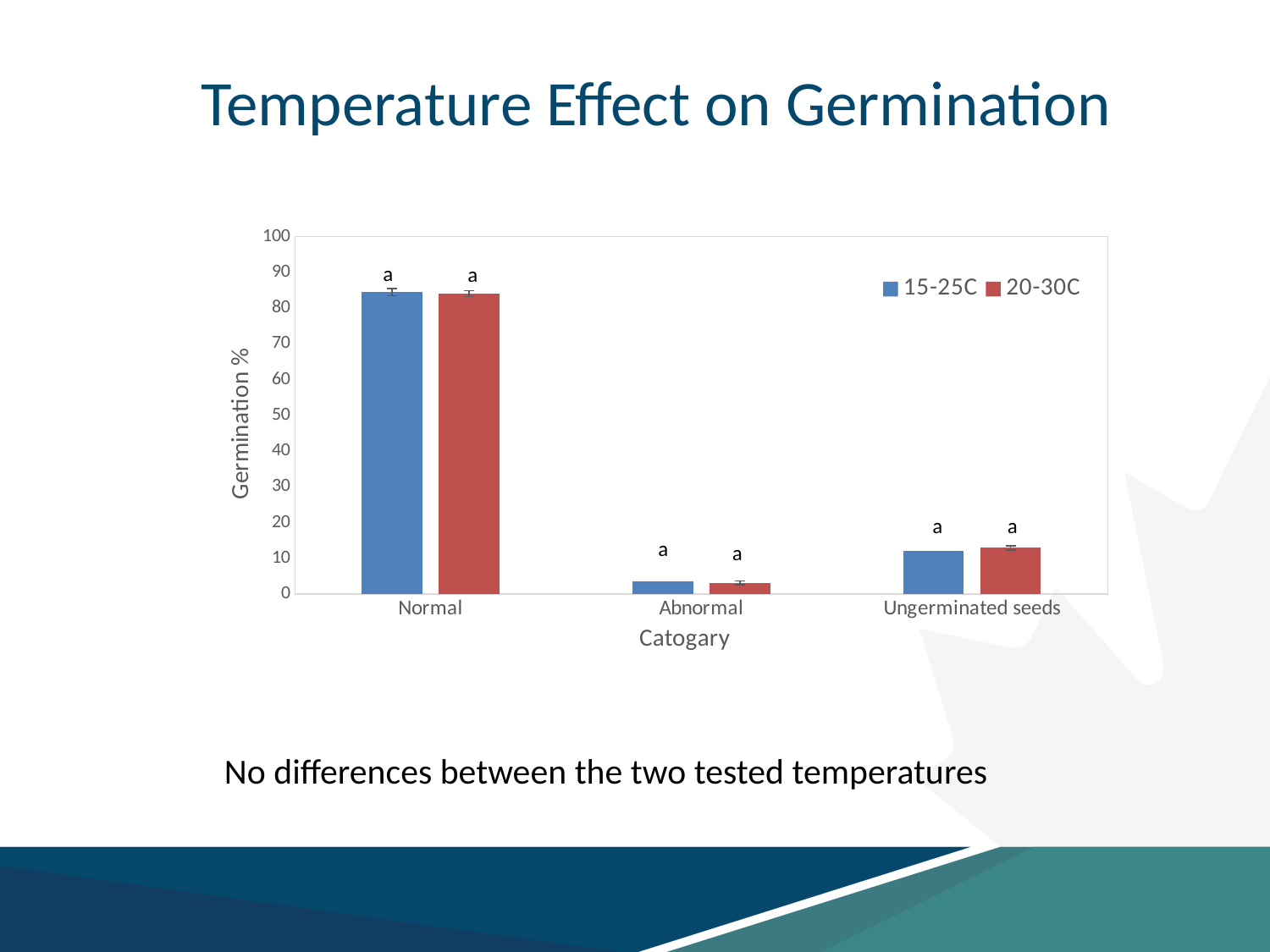
Which category has the highest value for the 15-25C series? Normal Which category has the lowest value for the 20-30C series? Abnormal How many categories are shown on the x axis? 3 Is the value for Abnormal in the 20-30C series greater or less than 10? less Is the value for Normal in the 20-30C series greater or less than 90? less What is the label of the y axis? Germination % What is the title of the chart? Temperature Effect on Germination How many series does the legend list? 2 Is the value for Normal in the 15-25C series greater or less than 80? greater What kind of chart is shown on the slide? bar chart Which is larger for the 15-25C series: Normal or Ungerminated seeds? Normal